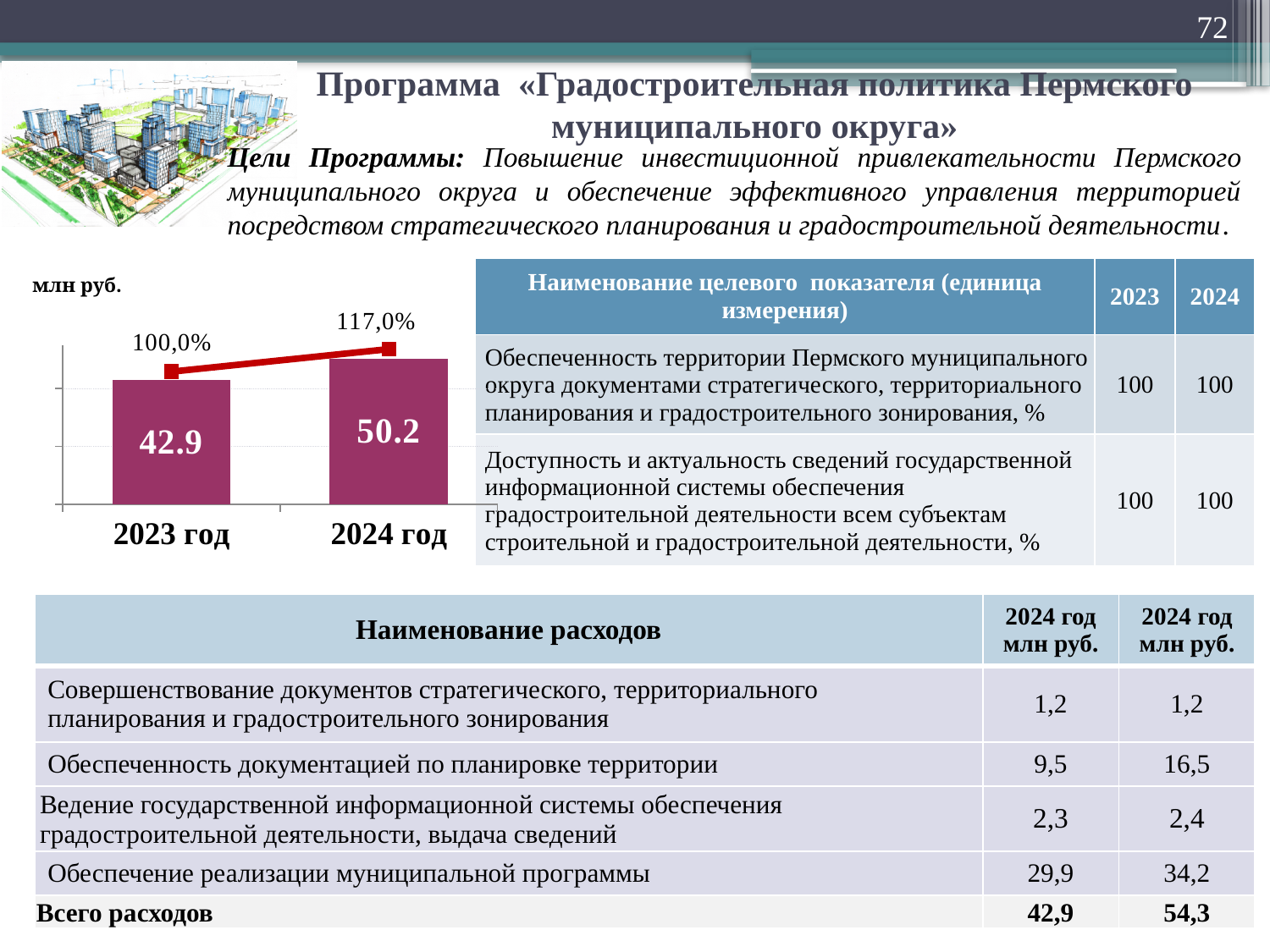
What percentage is shown above the 2024 год bar on the line in the chart? 117,0% What is the difference between the 2024 год and 2023 год bar values in the chart? 7.3 Do the bar values rise or fall from 2023 год to 2024 год? rise What percentage is shown above the 2023 год bar on the line in the chart? 100,0% How many categories (years) are shown on the x axis of the chart? 2 What is the value for 2024 год in the bar chart? 50.2 Is the bar value for 2024 год larger or smaller than the bar value for 2023 год? larger Which year has the lower bar in the chart? 2023 год Which year has the higher bar in the chart? 2024 год What unit is indicated above the chart? млн руб. What kind of chart is shown on the left of the slide? combination bar and line chart What is the value for 2023 год in the bar chart? 42.9